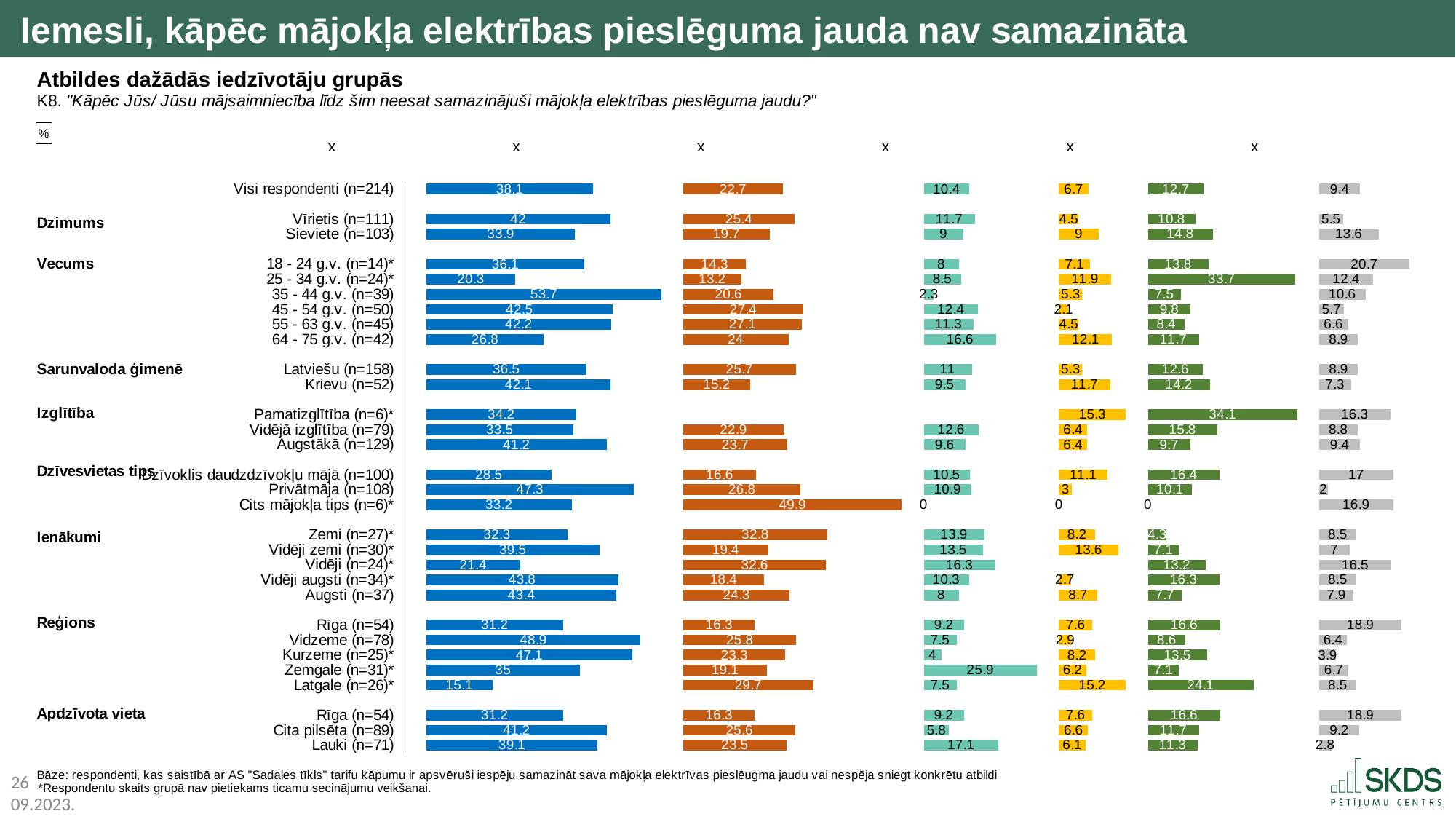
In the blue (first) series, which is larger: "Privātmāja (n=108)" or "Dzīvoklis daudzdzīvokļu mājā (n=100)"? Privātmāja (n=108) What is the difference between the blue (first) bar values for "Vīrietis (n=111)" and "Sieviete (n=103)"? 8.1 Among the age groups (Vecums), which category has the highest value in the blue (first) series? 35 - 44 g.v. (n=39) How many age-group categories are listed under "Vecums"? 6 What kind of chart is shown on the slide? bar chart What is the value of the teal (third) bar for "Zemgale (n=31)*"? 25.9 What is the value of the green (fifth) bar for "Pamatizglītība (n=6)*"? 34.1 Among the regions (Reģions), which category has the lowest value in the blue (first) series? Latgale (n=26)* What is the value of the orange (second) bar for "Vīrietis (n=111)"? 25.4 What is the value of the blue (first) bar for "Visi respondenti (n=214)"? 38.1 What is the difference between the blue (first) bar values for "Vidzeme (n=78)" and "Rīga (n=54)" under Reģions? 17.7 What is the value of the orange (second) bar for "Cits mājokļa tips (n=6)*"? 49.9